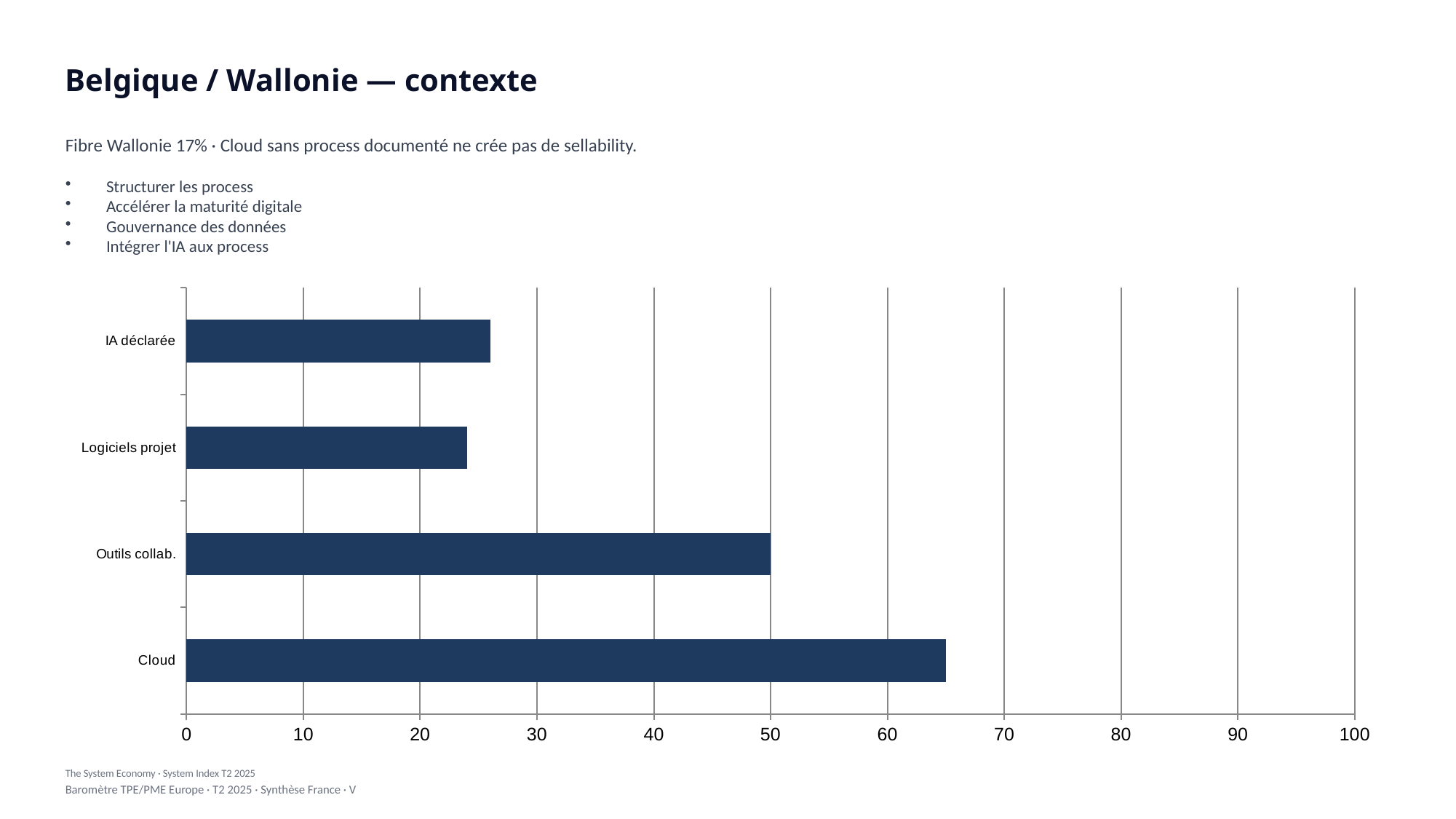
Which is larger, the value for Cloud or the value for Outils collab.? Cloud What kind of chart is shown on the slide? bar chart Is the value for Logiciels projet greater or less than 20? greater What colour are the bars in the chart? dark navy blue Which is larger, the value for Outils collab. or the value for IA déclarée? Outils collab. What is the value for Outils collab.? 50 Is the value for Outils collab. greater or less than 40? greater Is the value for Cloud greater or less than 60? greater Which category has the highest value in the chart? Cloud What is the maximum value shown on the horizontal axis of the chart? 100 How many categories are plotted in the chart? 4